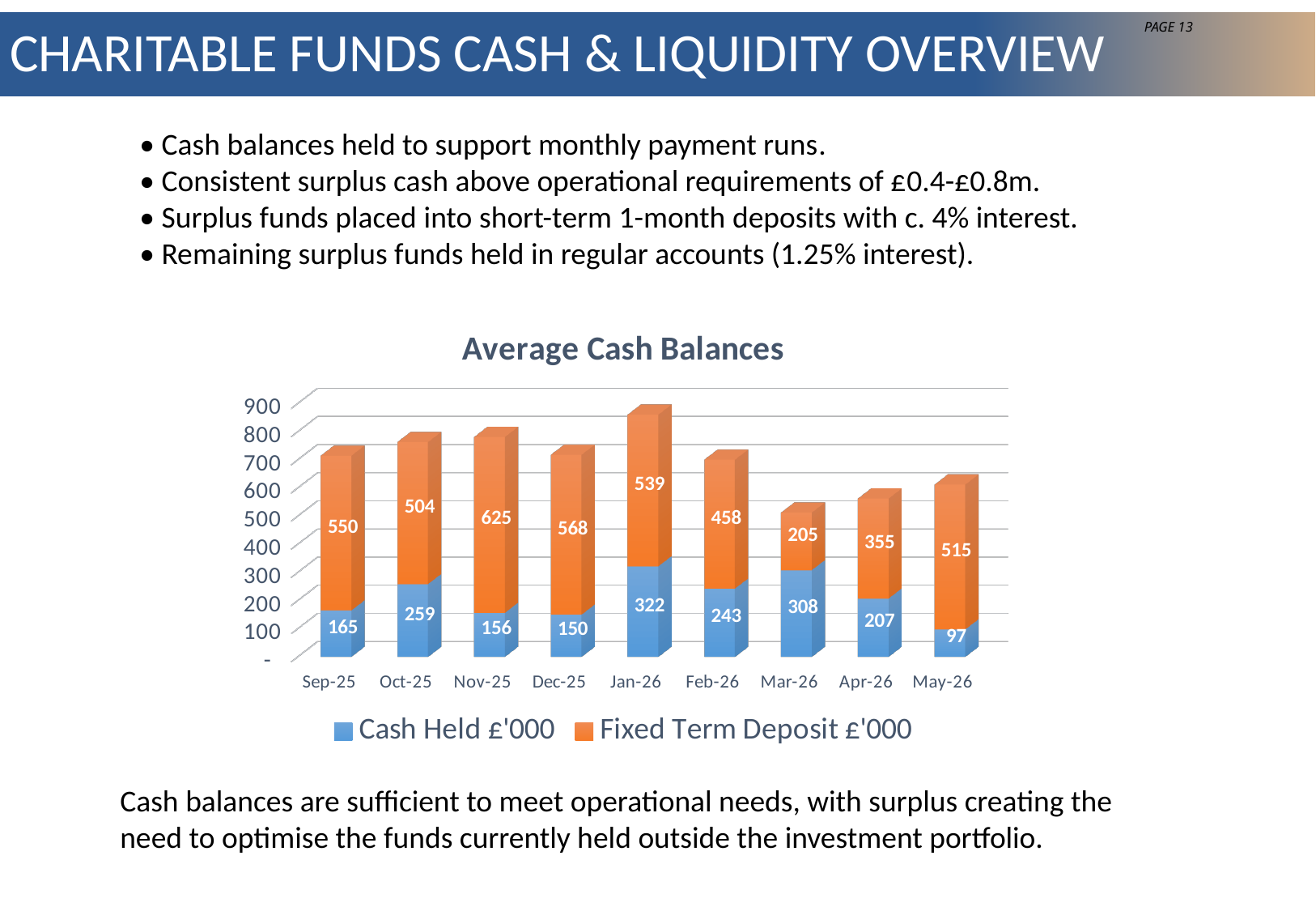
What kind of chart is shown? Stacked bar chart How many series does the legend list? 2 Which is larger, the Cash Held £'000 value for Oct-25 or for Feb-26? Oct-25 Which month has the highest Cash Held £'000 value? Jan-26 Which month has the lowest Fixed Term Deposit £'000 value? Mar-26 What is the Cash Held £'000 value for Jan-26? 322 What is the total of the stacked bar for Mar-26? 513 How many months are shown on the x axis? 9 What is the title of the chart? Average Cash Balances Is the total stacked bar for Jan-26 greater or less than 800? greater What is the difference between the Fixed Term Deposit £'000 values for Nov-25 and Mar-26? 420 What is the Fixed Term Deposit £'000 value for Nov-25? 625